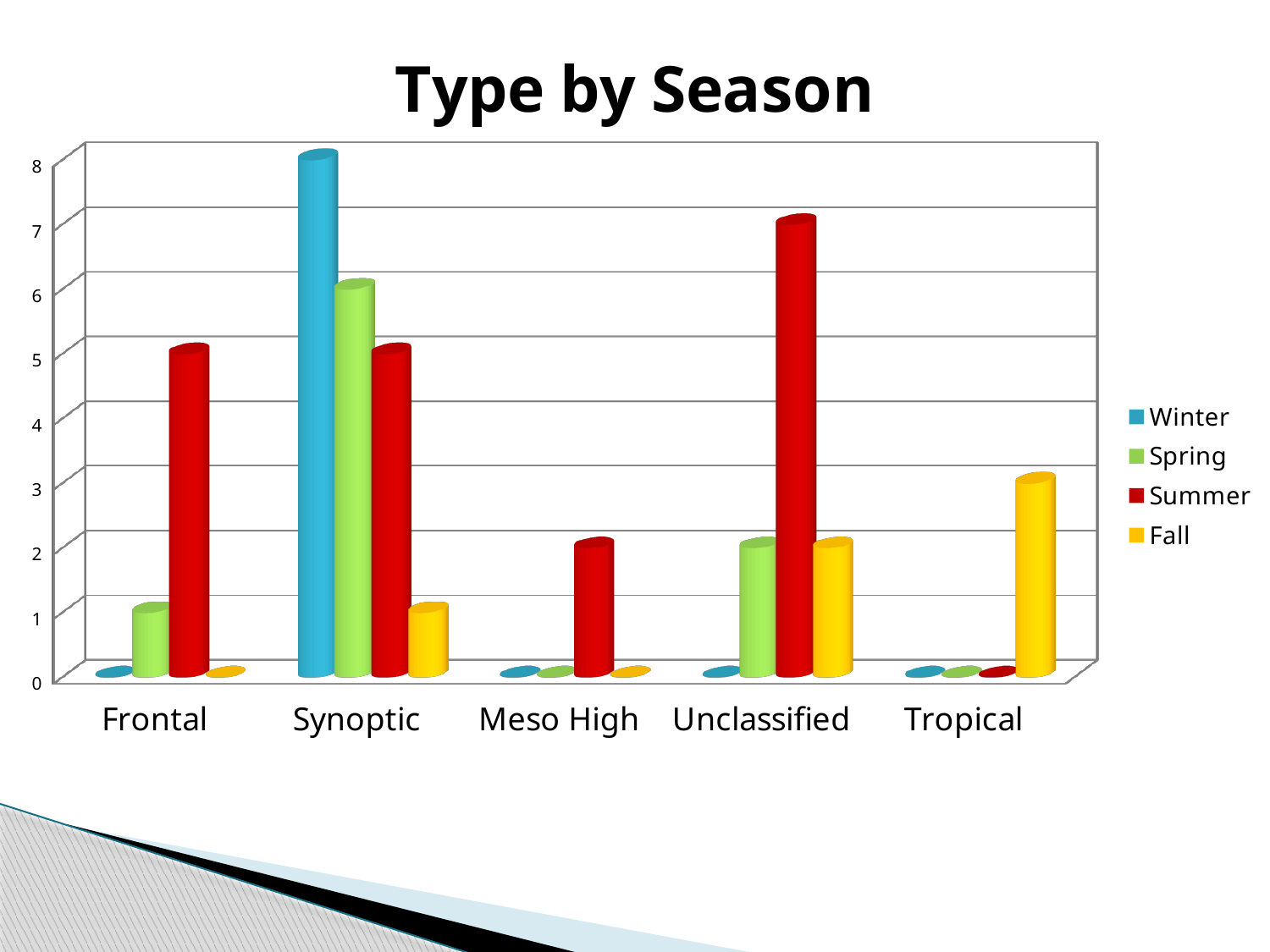
What is the Winter value for Synoptic? 8 What is the title of the chart? Type by Season How many categories are shown on the x axis? 5 Is the Fall value for Tropical greater or less than 4? less What kind of chart is shown on the slide? bar chart Which category has the highest Winter value? Synoptic Which is larger, the Spring value for Synoptic or the Spring value for Unclassified? Synoptic Is the Summer value for Frontal greater or less than 4? greater How many series does the legend list? 4 Which category has the highest Fall value? Tropical What is the Summer value for Unclassified? 7 Which category has the highest Summer value? Unclassified